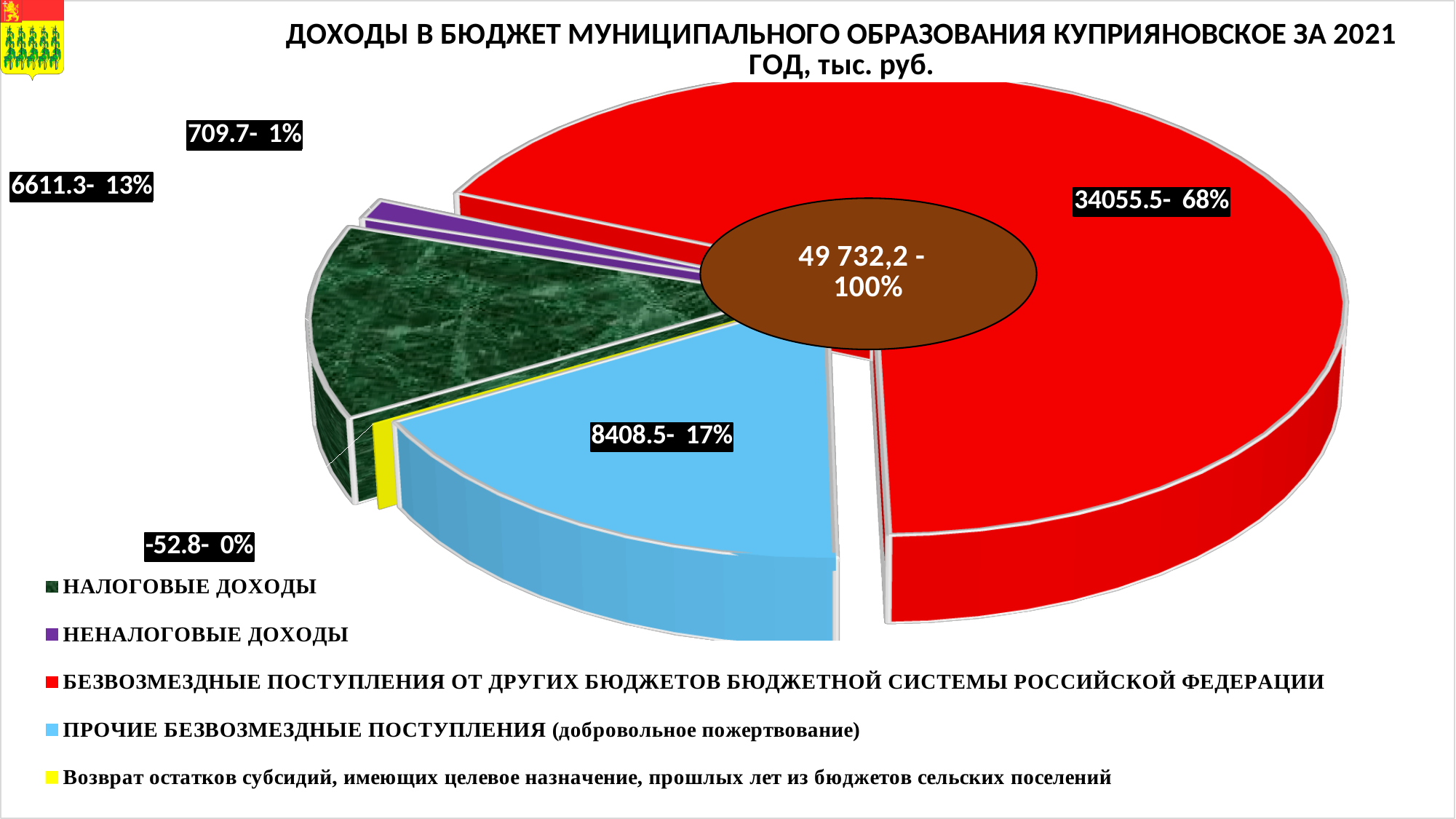
Which is larger, НАЛОГОВЫЕ ДОХОДЫ or НЕНАЛОГОВЫЕ ДОХОДЫ? НАЛОГОВЫЕ ДОХОДЫ What value is shown for НЕНАЛОГОВЫЕ ДОХОДЫ? 709.7 Which category has the largest slice of the pie? БЕЗВОЗМЕЗДНЫЕ ПОСТУПЛЕНИЯ ОТ ДРУГИХ БЮДЖЕТОВ БЮДЖЕТНОЙ СИСТЕМЫ РОССИЙСКОЙ ФЕДЕРАЦИИ What value is shown for БЕЗВОЗМЕЗДНЫЕ ПОСТУПЛЕНИЯ ОТ ДРУГИХ БЮДЖЕТОВ БЮДЖЕТНОЙ СИСТЕМЫ РОССИЙСКОЙ ФЕДЕРАЦИИ? 34055.5 What value is shown for ПРОЧИЕ БЕЗВОЗМЕЗДНЫЕ ПОСТУПЛЕНИЯ (добровольное пожертвование)? 8408.5 What is the difference between the values for ПРОЧИЕ БЕЗВОЗМЕЗДНЫЕ ПОСТУПЛЕНИЯ (добровольное пожертвование) and НАЛОГОВЫЕ ДОХОДЫ? 1797.2 What share of the pie does ПРОЧИЕ БЕЗВОЗМЕЗДНЫЕ ПОСТУПЛЕНИЯ (добровольное пожертвование) represent? 17% What value is shown for НАЛОГОВЫЕ ДОХОДЫ? 6611.3 What kind of chart is shown on the slide? pie chart What share of the pie does НАЛОГОВЫЕ ДОХОДЫ represent? 13% Which category has the smallest value in the chart? Возврат остатков субсидий, имеющих целевое назначение, прошлых лет из бюджетов сельских поселений How many categories does the legend list? 5